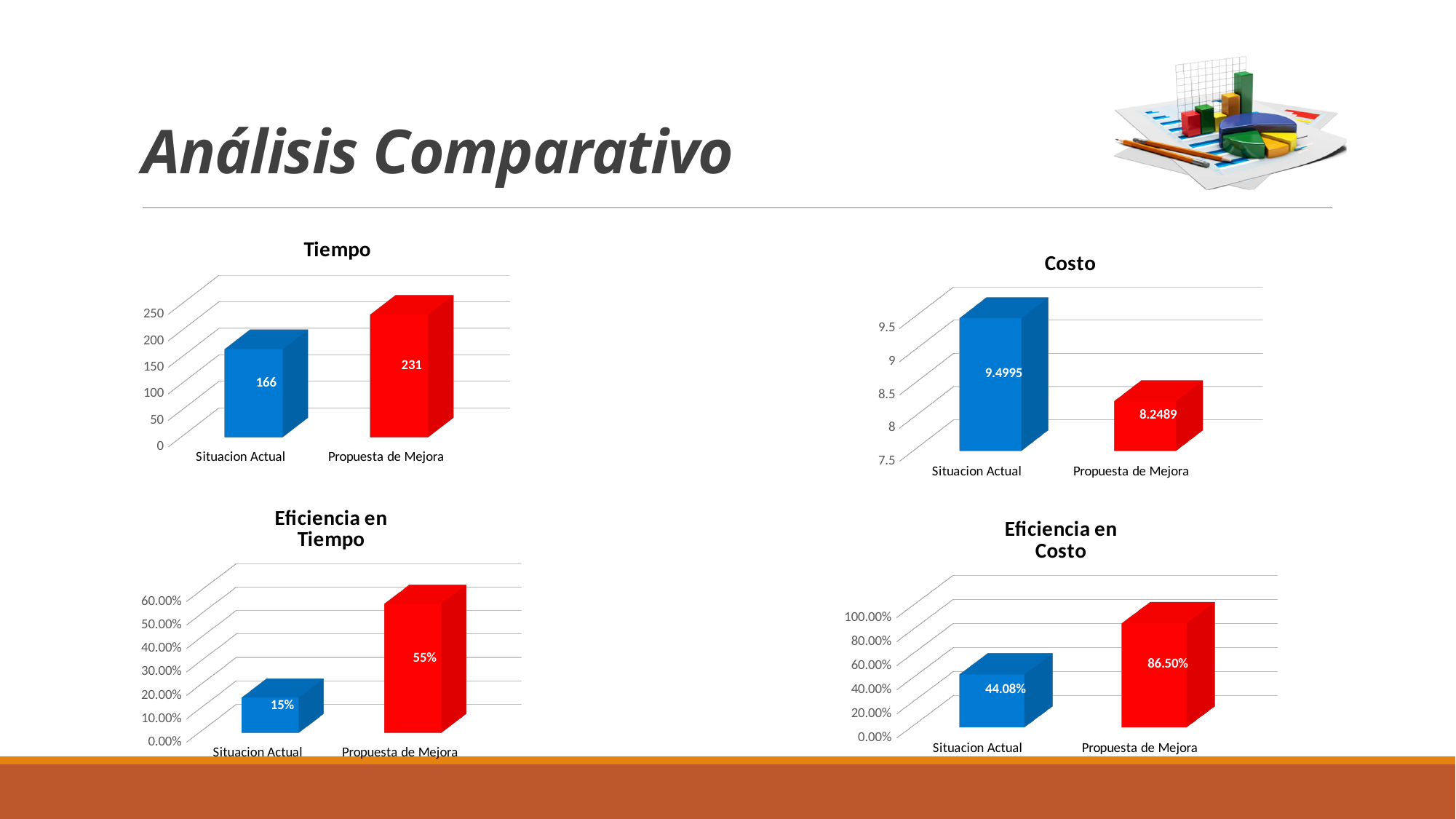
In the 'Eficiencia en Costo' chart, what is the value for Situacion Actual? 44.08% In the 'Eficiencia en Tiempo' chart, which is larger, Situacion Actual or Propuesta de Mejora? Propuesta de Mejora In the 'Tiempo' chart, what is the value for Situacion Actual? 166 In the 'Tiempo' chart, what is the value for Propuesta de Mejora? 231 In the 'Costo' chart, which category has the lowest value? Propuesta de Mejora In the 'Costo' chart, what is the value for Situacion Actual? 9.4995 In the 'Eficiencia en Costo' chart, what is the value for Propuesta de Mejora? 86.50% In the 'Eficiencia en Tiempo' chart, what is the value for Propuesta de Mejora? 55% In the 'Costo' chart, is the value for Propuesta de Mejora greater or less than 8.5? less What kind of chart is the 'Tiempo' chart? bar chart In the 'Tiempo' chart, what is the difference between Propuesta de Mejora and Situacion Actual? 65 How many categories does the 'Eficiencia en Costo' chart show? 2